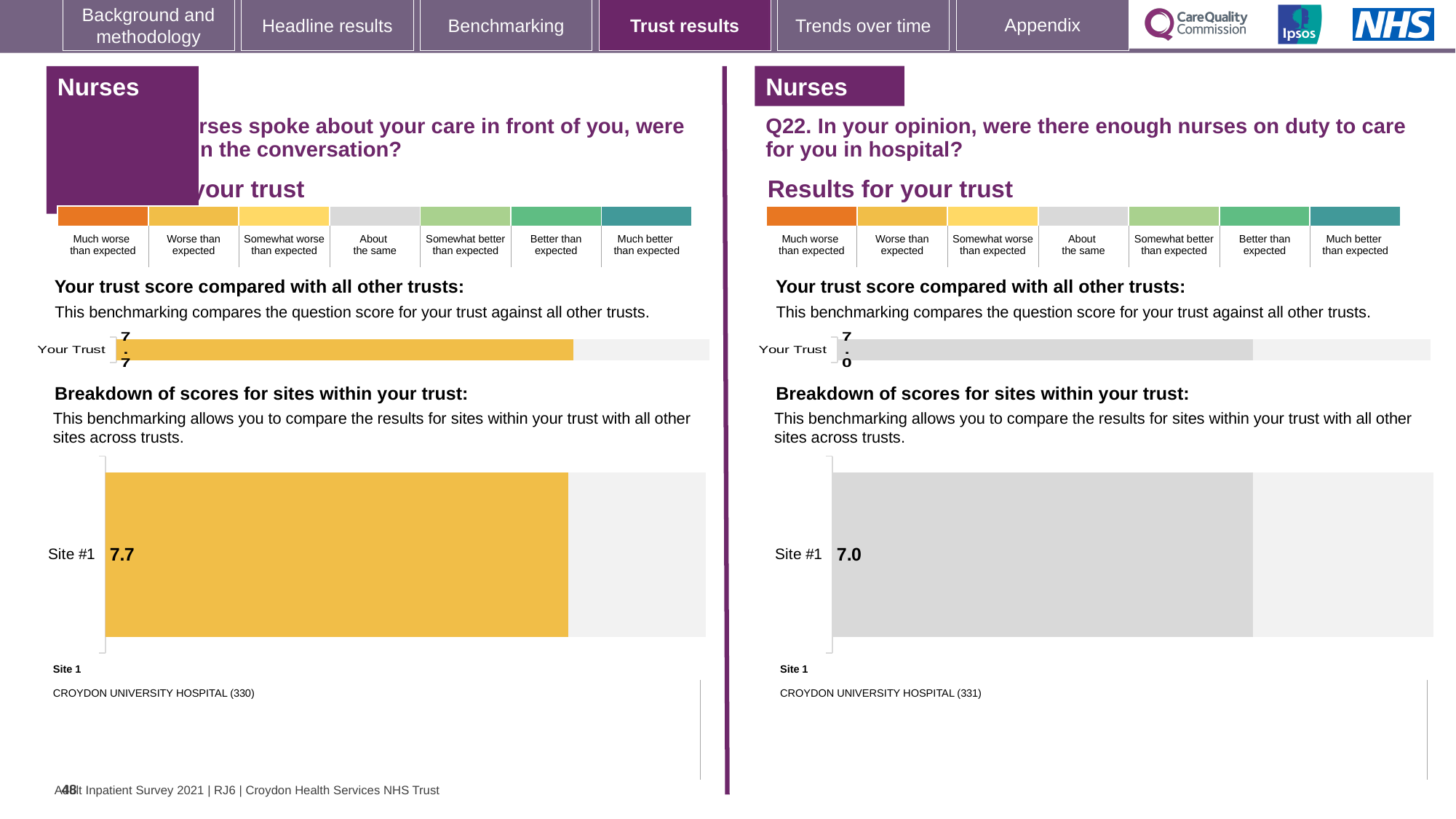
What colour is the Site #1 bar on the left half of the slide? Yellow Is the Site #1 score on the right half of the slide (Q22) equal to the 'Your Trust' score on the same half? Yes Which site name is listed under the breakdown chart on the right half of the slide (Q22)? CROYDON UNIVERSITY HOSPITAL (331) Which is larger: the Site #1 score on the left half of the slide or the Site #1 score on the right half (Q22)? Left half (7.7) How many sites are shown in the breakdown of scores chart on the left half of the slide? 1 On the right half of the slide (Q22), what score is shown for Site #1 in the breakdown of scores for sites within your trust? 7.0 On the left half of the slide, what score is shown for Site #1 in the breakdown of scores for sites within your trust? 7.7 What kind of chart is used to show the Site #1 score on the right half of the slide (Q22)? Bar chart What is the difference between the Site #1 score on the left half of the slide and the Site #1 score on the right half (Q22)? 0.7 On the right half of the slide (Q22), what is the value shown for 'Your Trust' in the trust score comparison bar? 7.0 How many sites are shown in the breakdown of scores chart on the right half of the slide (Q22)? 1 On the left half of the slide, what is the value shown for 'Your Trust' in the trust score comparison bar? 7.7